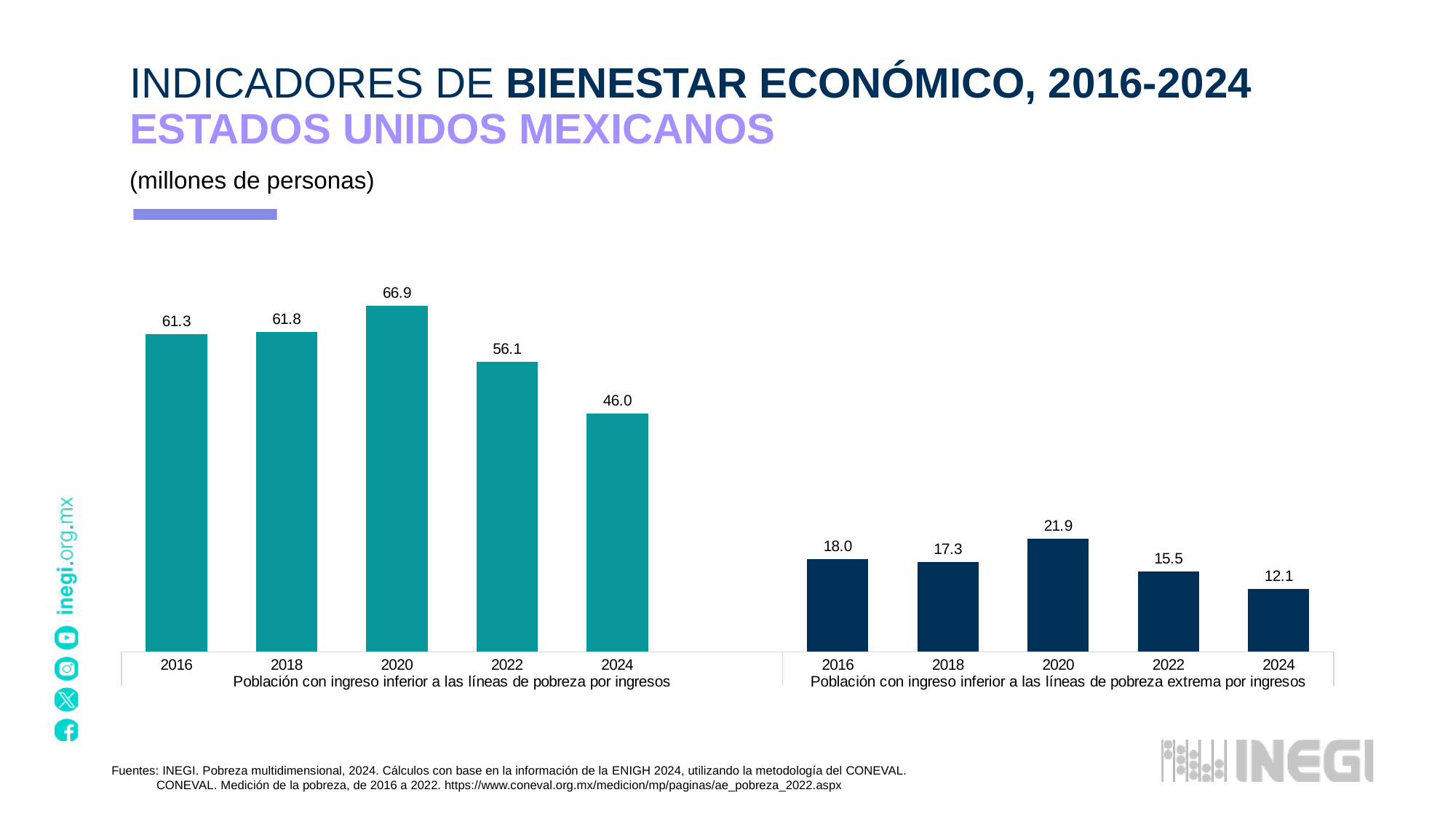
In the group 'Población con ingreso inferior a las líneas de pobreza extrema por ingresos', do the values rise or fall from 2020 to 2024? Fall In the group 'Población con ingreso inferior a las líneas de pobreza por ingresos', which year has the lowest value? 2024 What kind of chart is shown on the slide? Bar chart In the group 'Población con ingreso inferior a las líneas de pobreza extrema por ingresos', what is the value for 2024? 12.1 In the group 'Población con ingreso inferior a las líneas de pobreza por ingresos', what is the value for 2016? 61.3 In the group 'Población con ingreso inferior a las líneas de pobreza por ingresos', what is the value for 2020? 66.9 In the group 'Población con ingreso inferior a las líneas de pobreza extrema por ingresos', what is the difference between the 2016 and 2018 values? 0.7 What unit is stated below the slide title for the chart values? millones de personas How many years are shown in each group of bars? 5 In the group 'Población con ingreso inferior a las líneas de pobreza por ingresos', what is the difference between the 2020 and 2024 values? 20.9 In the group 'Población con ingreso inferior a las líneas de pobreza extrema por ingresos', which year has the highest value? 2020 Which is larger: the 2022 value for 'pobreza por ingresos' or the 2022 value for 'pobreza extrema por ingresos'? pobreza por ingresos (56.1)